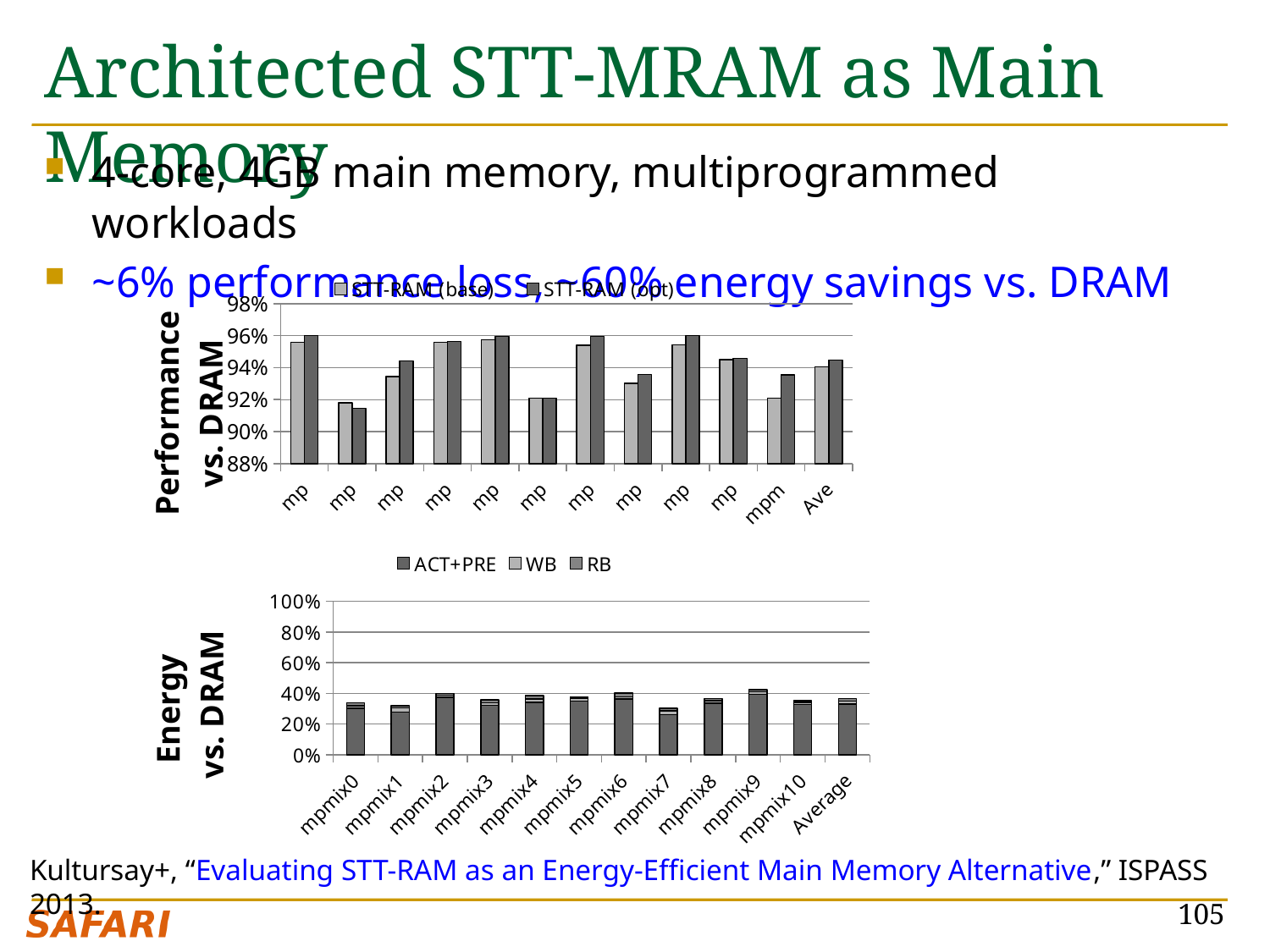
In the 'Performance vs. DRAM' chart, is the STT-RAM (base) value for Ave greater or less than 92%? greater In the 'Energy vs. DRAM' chart, is the total for Average greater or less than 40%? less What are the legend entries of the 'Energy vs. DRAM' chart? ACT+PRE, WB, RB In the 'Energy vs. DRAM' chart, which has the taller total bar, mpmix0 or mpmix2? mpmix2 How many series does the legend of the 'Energy vs. DRAM' chart list? 3 How many categories are shown on the x axis of the 'Energy vs. DRAM' chart? 12 How many series does the legend of the 'Performance vs. DRAM' chart list? 2 In the 'Energy vs. DRAM' chart, which has the taller total bar, mpmix9 or mpmix7? mpmix9 What type of chart is the 'Energy vs. DRAM' chart at the bottom of the slide? Stacked bar chart In the 'Energy vs. DRAM' chart, is the total for mpmix2 greater or less than 20%? greater In the 'Performance vs. DRAM' chart, which series has the taller bar for the mpm category, STT-RAM (base) or STT-RAM (opt)? STT-RAM (opt)